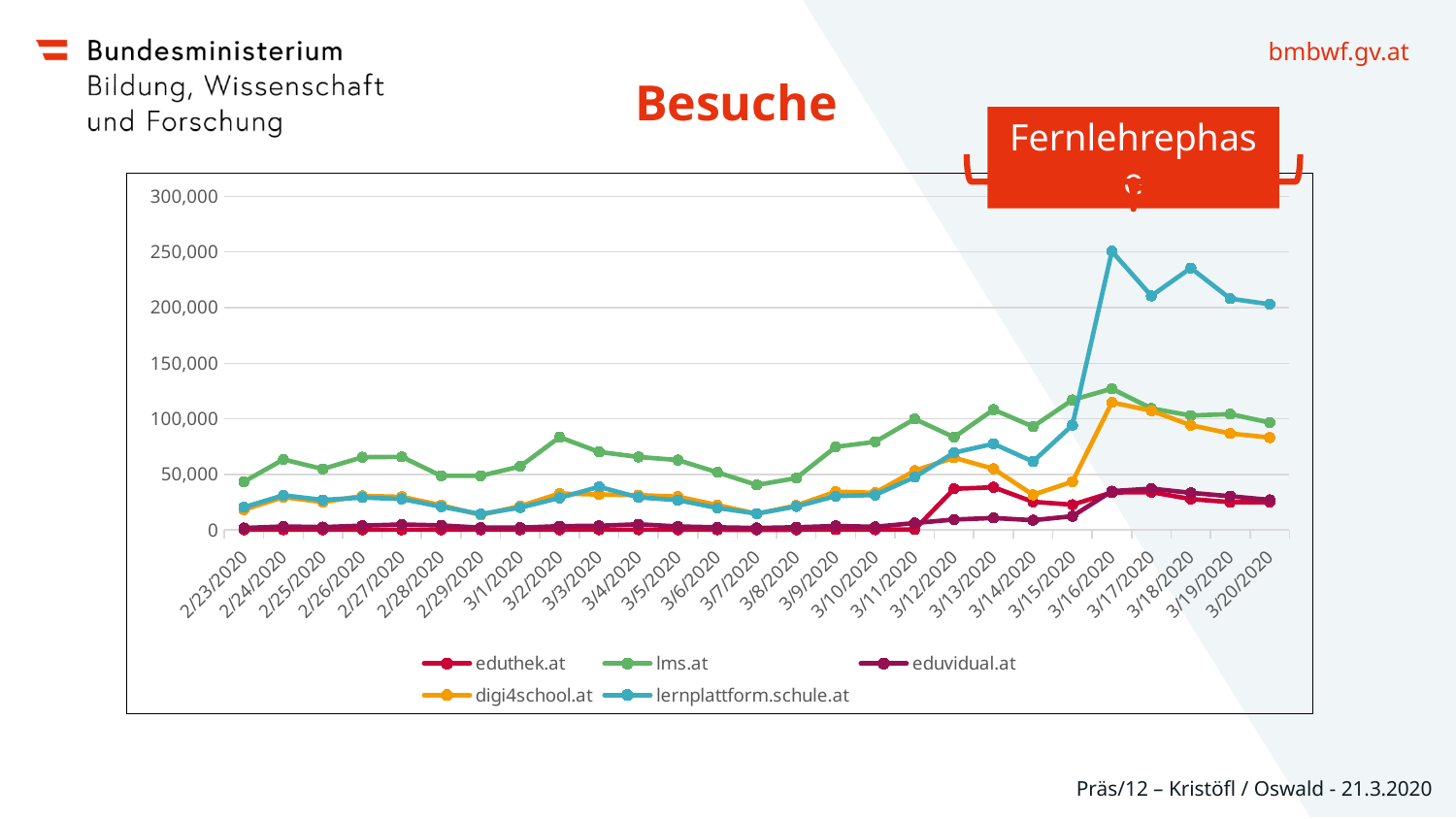
What is the title of the chart? Besuche Which series reaches the highest value in the chart? lernplattform.schule.at What kind of chart is shown on the slide? line chart How many dates are plotted along the x axis of the chart? 27 Which series is drawn in green in the chart? lms.at How many series does the legend of the chart list? 5 Is the value for lms.at on 3/16/2020 greater or less than 100,000? greater Is the value for lernplattform.schule.at on 3/16/2020 greater or less than 200,000? greater On 3/16/2020, which series has the larger value, lernplattform.schule.at or lms.at? lernplattform.schule.at Is the value for eduthek.at on 3/20/2020 greater or less than 50,000? less Do the values for lernplattform.schule.at rise or fall from 3/16/2020 to 3/20/2020? fall On which date does lernplattform.schule.at reach its highest value? 3/16/2020